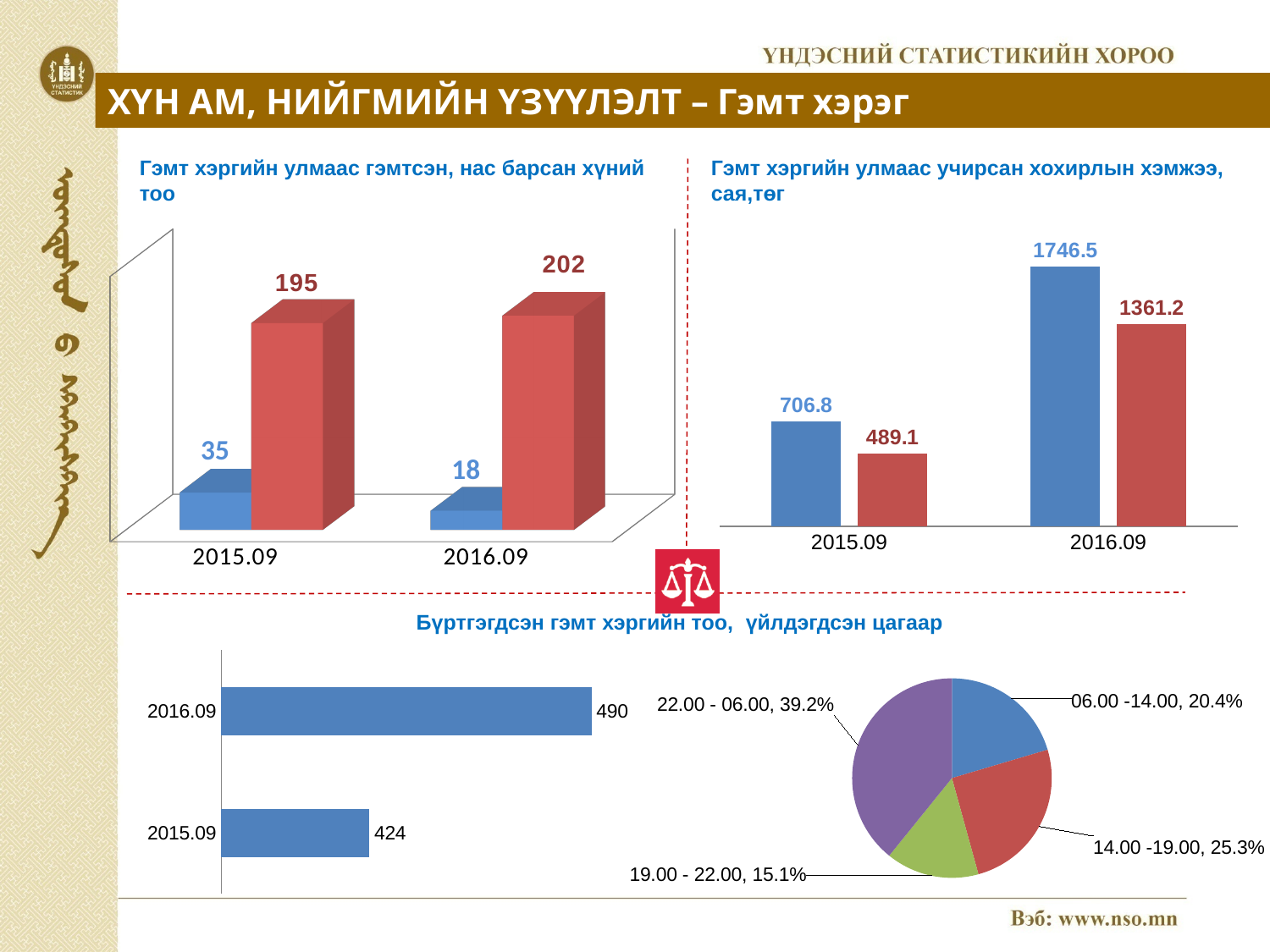
In the top-right chart (Гэмт хэргийн улмаас учирсан хохирлын хэмжээ, сая,төг), what is the value of the blue bar for 2016.09? 1746.5 In the top-left chart (Гэмт хэргийн улмаас гэмтсэн, нас барсан хүний тоо), what is the value of the blue bar for 2015.09? 35 In the top-left chart (Гэмт хэргийн улмаас гэмтсэн, нас барсан хүний тоо), did the blue bar value rise or fall from 2015.09 to 2016.09? fall In the top-left chart (Гэмт хэргийн улмаас гэмтсэн, нас барсан хүний тоо), what is the difference between the red bar values for 2016.09 and 2015.09? 7 In the top-right chart (Гэмт хэргийн улмаас учирсан хохирлын хэмжээ, сая,төг), which bar is the highest? Blue bar for 2016.09 (1746.5) In the bottom-left chart (Бүртгэгдсэн гэмт хэргийн тоо, үйлдэгдсэн цагаар), what is the value for 2016.09? 490 In the top-left chart (Гэмт хэргийн улмаас гэмтсэн, нас барсан хүний тоо), what is the value of the red bar for 2016.09? 202 In the top-right chart (Гэмт хэргийн улмаас учирсан хохирлын хэмжээ, сая,төг), what is the value of the red bar for 2015.09? 489.1 In the bottom-left chart (Бүртгэгдсэн гэмт хэргийн тоо, үйлдэгдсэн цагаар), what is the difference between the 2016.09 and 2015.09 values? 66 In the top-right chart (Гэмт хэргийн улмаас учирсан хохирлын хэмжээ, сая,төг), which is larger: the blue bar for 2015.09 or the red bar for 2016.09? Red bar for 2016.09 In the bottom-right pie chart, what share does the 22.00 - 06.00 slice have? 39.2% In the bottom-right pie chart, which time period has the smallest share? 19.00 - 22.00